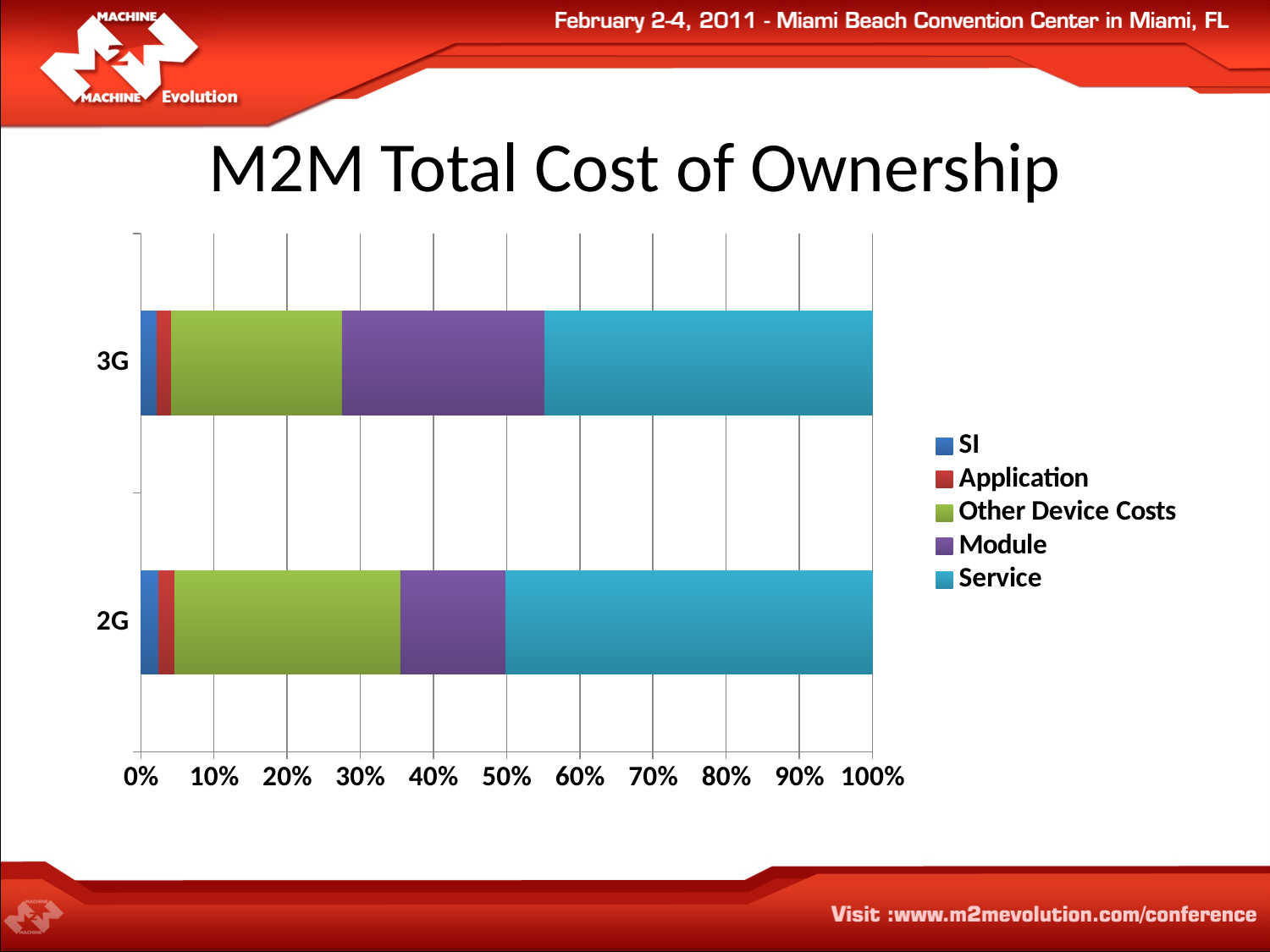
What is the total of the stacked bar for 3G? 100% Is the Module share for 2G greater or less than 20%? less Is the Module share for 3G greater or less than 20%? greater Is the Module share larger for 3G or for 2G? 3G Is the Other Device Costs share larger for 2G or for 3G? 2G What kind of chart is shown on the slide? Stacked bar chart What is the title of the chart? M2M Total Cost of Ownership How many categories are plotted on the chart? 2 Which series takes the smallest share of the 3G bar? Application How many series does the legend list? 5 Which series is shown in green in the legend? Other Device Costs Which series takes the largest share of the 2G bar? Service